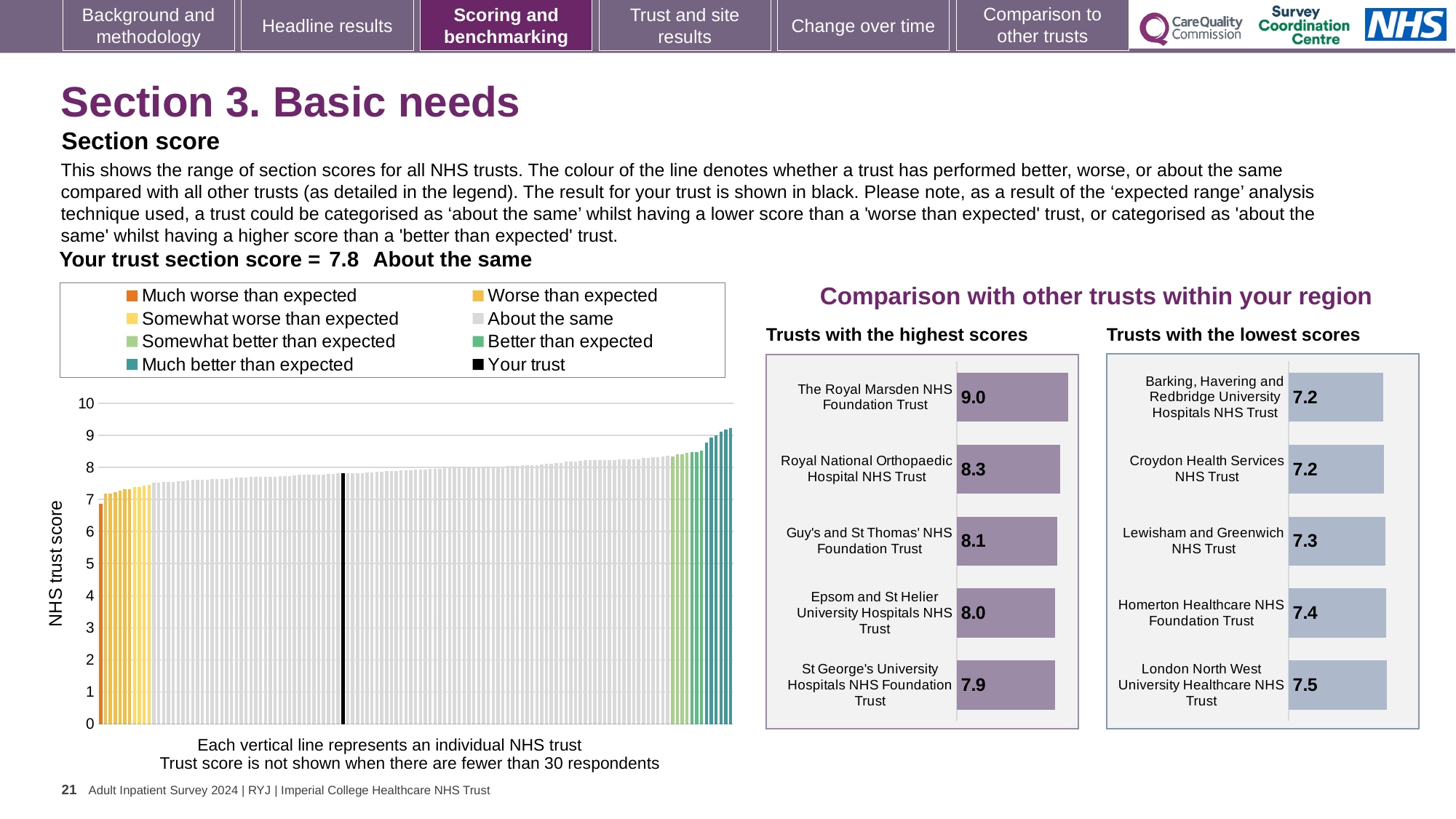
In the 'Trusts with the lowest scores' chart, what is the score for Croydon Health Services NHS Trust? 7.2 In the 'Trusts with the highest scores' chart, what is the score for The Royal Marsden NHS Foundation Trust? 9.0 In the 'Trusts with the lowest scores' chart, which trust has the highest score? London North West University Healthcare NHS Trust How many trusts are shown in the 'Trusts with the lowest scores' chart? 5 In the 'Trusts with the highest scores' chart, which trust has the highest score? The Royal Marsden NHS Foundation Trust In the 'Trusts with the lowest scores' chart, what is the difference between the scores of Homerton Healthcare NHS Foundation Trust and Lewisham and Greenwich NHS Trust? 0.1 How many entries does the legend of the 'NHS trust score' chart on the left list? 8 In the 'Trusts with the highest scores' chart, which has the higher score: Guy's and St Thomas' NHS Foundation Trust or Epsom and St Helier University Hospitals NHS Trust? Guy's and St Thomas' NHS Foundation Trust What kind of chart is the 'NHS trust score' chart on the left of the slide? Bar chart In the 'NHS trust score' chart on the left, do the values rise or fall from left to right? Rise In the 'Trusts with the highest scores' chart, what is the difference between the scores of The Royal Marsden NHS Foundation Trust and St George's University Hospitals NHS Foundation Trust? 1.1 In the 'NHS trust score' chart on the left, is the tallest bar greater or less than 9? greater